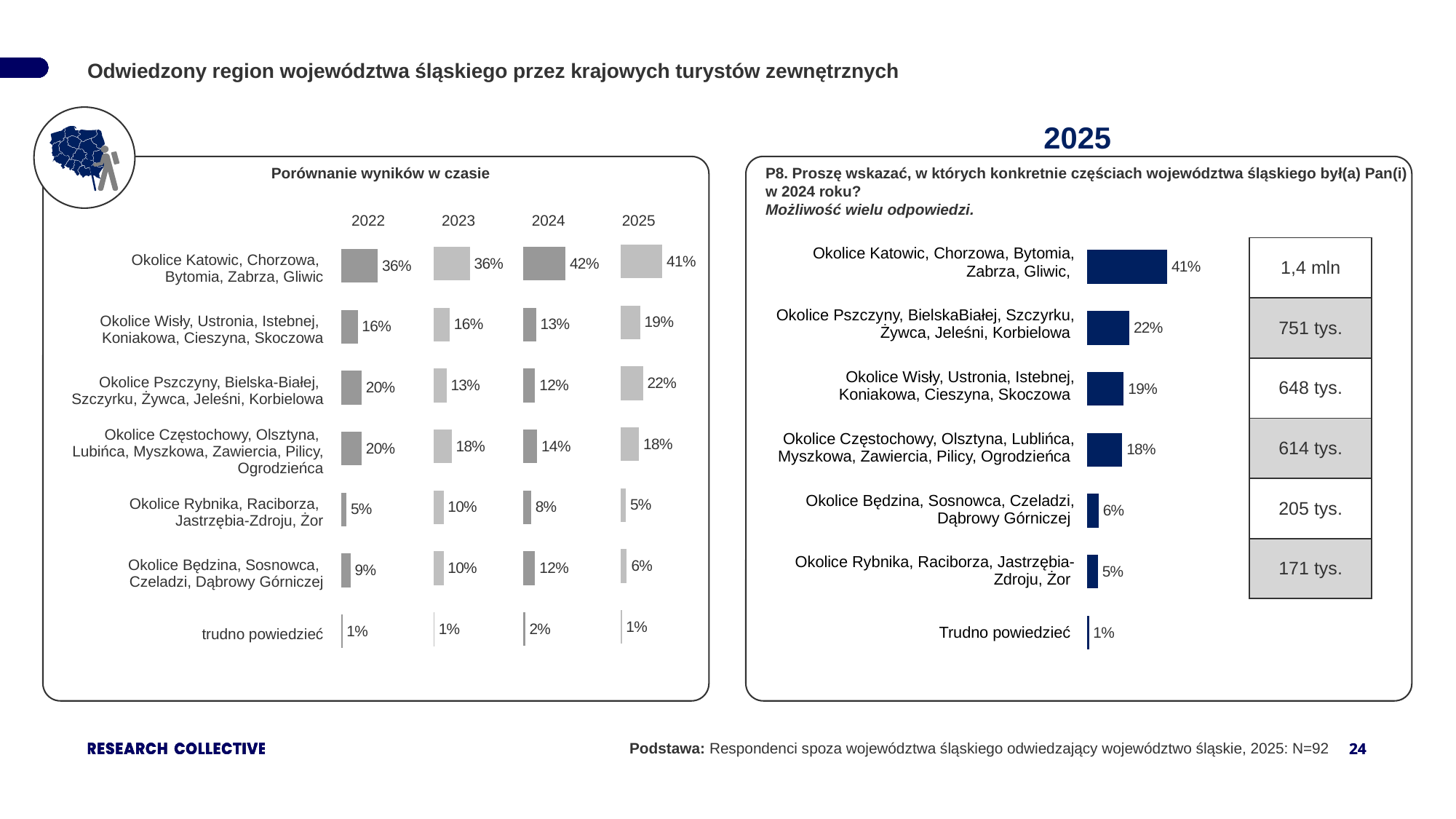
In the right chart '2025', how many categories are plotted? 7 In the left chart 'Porównanie wyników w czasie', which category has the highest value in 2025? Okolice Katowic, Chorzowa, Bytomia, Zabrza, Gliwic In the left chart 'Porównanie wyników w czasie', did the value for Okolice Rybnika, Raciborza, Jastrzębia-Zdroju, Żor rise or fall from 2023 to 2025? fall In the right chart '2025', which is larger: the value for Okolice Pszczyny, Bielska-Białej, Szczyrku, Żywca, Jeleśni, Korbielowa or for Okolice Wisły, Ustronia, Istebnej, Koniakowa, Cieszyna, Skoczowa? Okolice Pszczyny, Bielska-Białej, Szczyrku, Żywca, Jeleśni, Korbielowa In the right chart '2025', what is the difference between the values for Okolice Katowic, Chorzowa, Bytomia, Zabrza, Gliwic and Okolice Będzina, Sosnowca, Czeladzi, Dąbrowy Górniczej? 35% In the left chart 'Porównanie wyników w czasie', what is the value for Okolice Pszczyny, Bielska-Białej, Szczyrku, Żywca, Jeleśni, Korbielowa in 2023? 13% In the left chart 'Porównanie wyników w czasie', how many years are compared? 4 In the left chart 'Porównanie wyników w czasie', what is the value for Okolice Katowic, Chorzowa, Bytomia, Zabrza, Gliwic in 2024? 42% In the right chart '2025', which category has the lowest value? Trudno powiedzieć What kind of chart is the right chart '2025'? bar chart In the right chart '2025', what is the value for Okolice Częstochowy, Olsztyna, Lublińca, Myszkowa, Zawiercia, Pilicy, Ogrodzieńca? 18% In the left chart 'Porównanie wyników w czasie', what is the difference between the 2022 and 2025 values for Okolice Będzina, Sosnowca, Czeladzi, Dąbrowy Górniczej? 3%